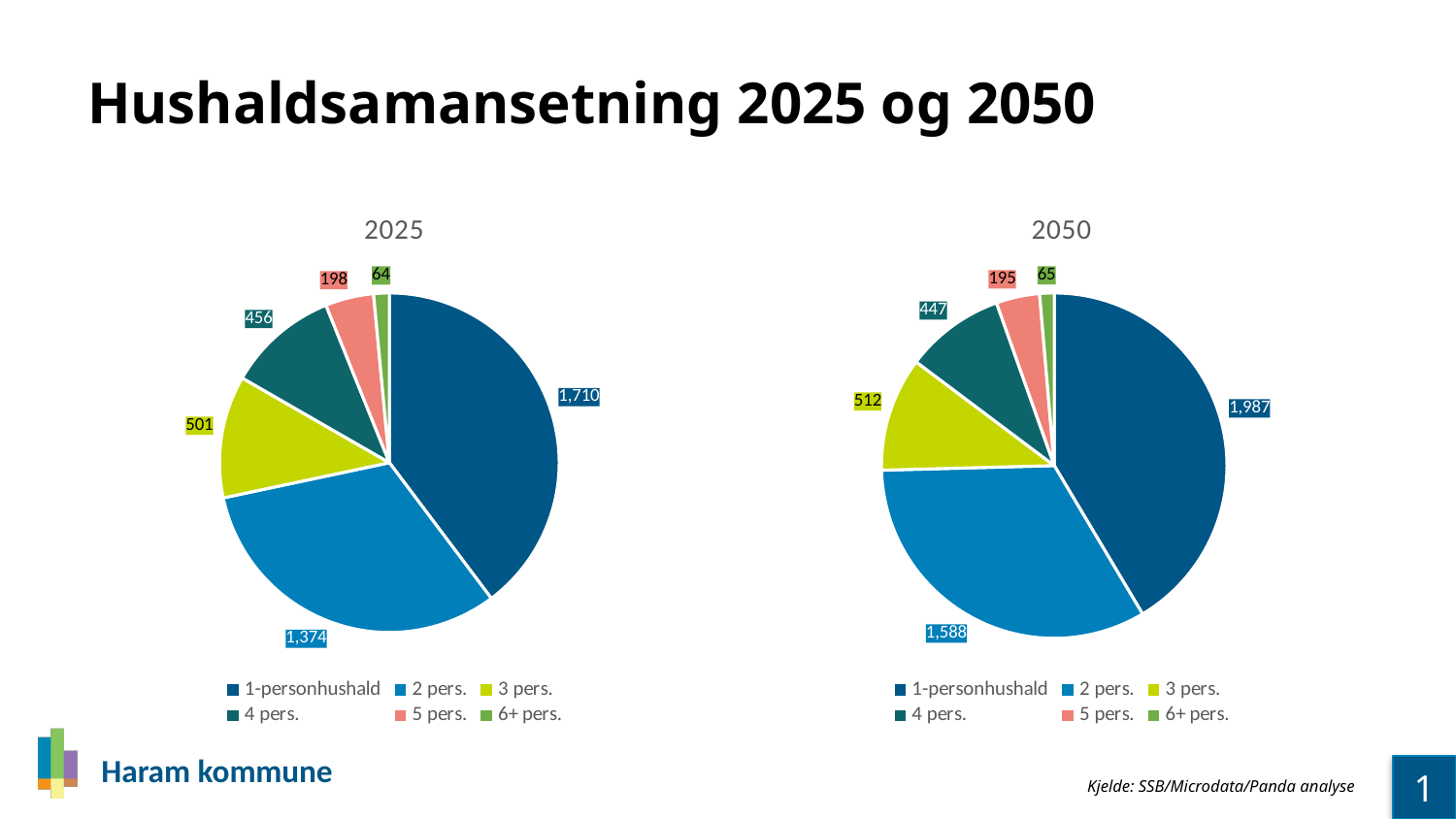
In the 2025 pie chart, which category has the smallest slice? 6+ pers. How many categories does the 2025 pie chart show? 6 In the 2050 pie chart, what is the value for 6+ pers.? 65 In the 2025 pie chart, what is the value for 4 pers.? 456 Is the value for 3 pers. larger in the 2025 chart or the 2050 chart? 2050 In the 2050 pie chart, which category has the largest slice? 1-personhushald What type of chart is used for the 2050 data? Pie chart What is the title of the slide? Hushaldsamansetning 2025 og 2050 In the 2025 pie chart, what is the difference between the values for 1-personhushald and 2 pers.? 336 In the 2025 pie chart, what is the value for 1-personhushald? 1,710 In the 2050 pie chart, what is the value for 2 pers.? 1,588 What is the difference between the 1-personhushald value in the 2050 chart and in the 2025 chart? 277